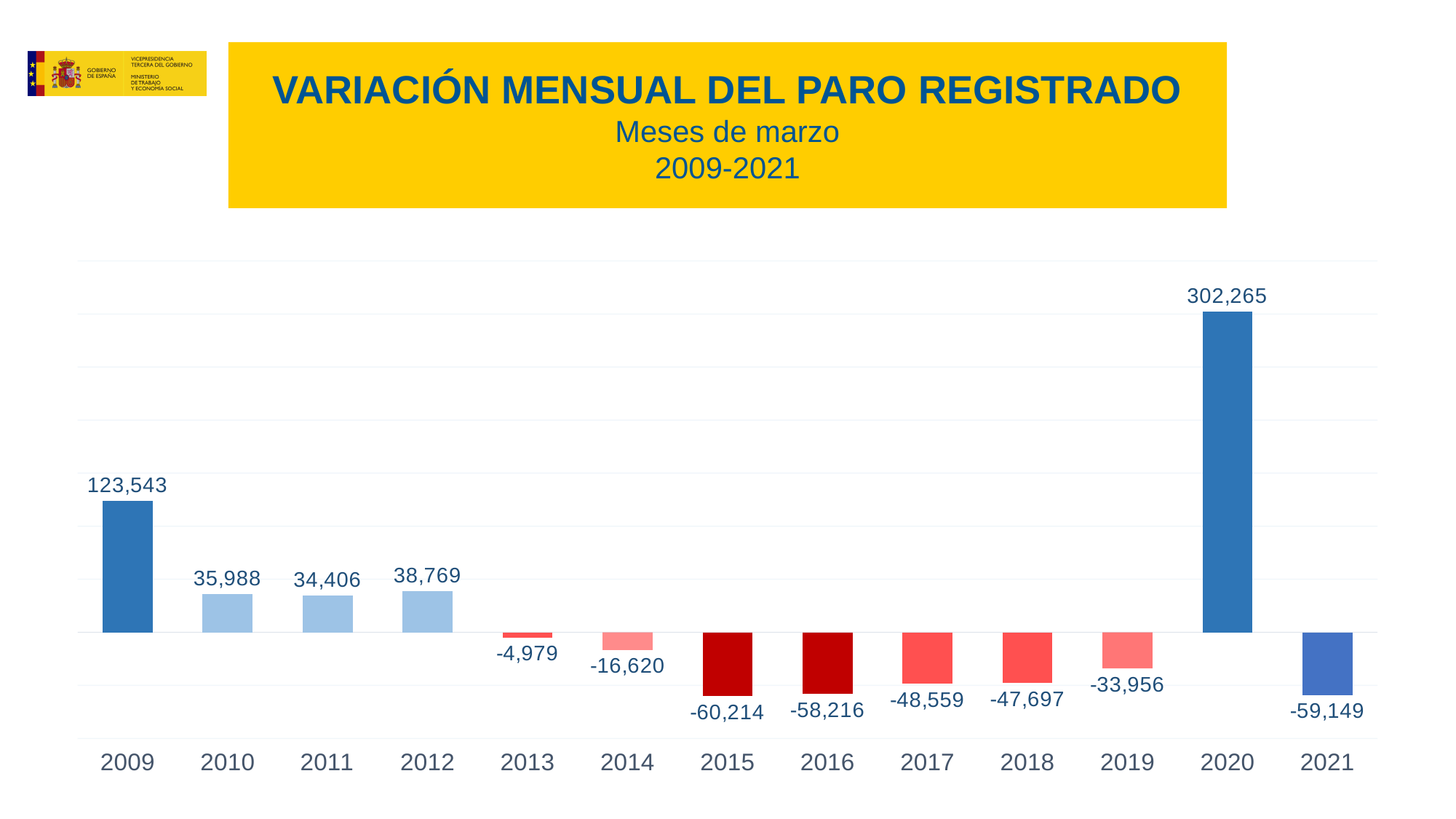
Which is larger, the value for 2010 or the value for 2012? 2012 What kind of chart is this? Bar chart Which year has the highest value? 2020 What is the main title of the chart? VARIACIÓN MENSUAL DEL PARO REGISTRADO Which year has the lowest value? 2015 What is the value shown for 2020? 302,265 What is the difference between the values for 2012 and 2010? 2,781 What is the value shown for 2015? -60,214 How many years are shown on the x axis? 13 What is the difference between the values for 2020 and 2009? 178,722 What is the value shown for 2013? -4,979 What is the value shown for 2021? -59,149